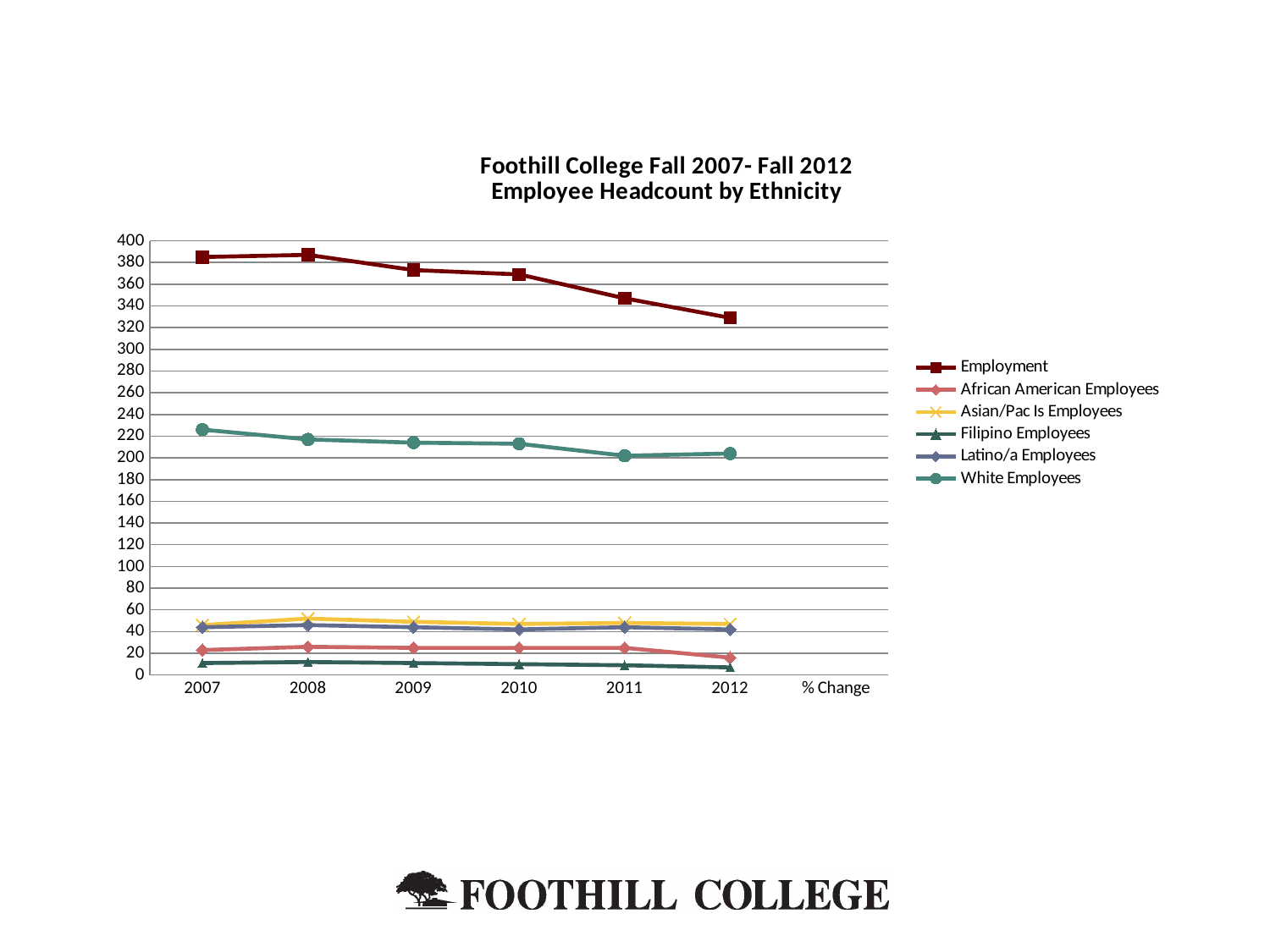
What kind of chart is shown on the slide? line chart Is the value for Filipino Employees in 2012 greater or less than 20? less Is the value for White Employees in 2011 greater or less than 220? less What is the title of the chart? Foothill College Fall 2007- Fall 2012 Employee Headcount by Ethnicity Is the value for Employment in 2012 greater or less than 340? less Which series has the lowest values across all years? Filipino Employees In which year is the Employment series at its lowest? 2012 Which is larger for White Employees: the value in 2007 or the value in 2012? 2007 How many series does the legend list? 6 Does the Employment series rise or fall from 2007 to 2012? fall Which series has the highest values across all years? Employment